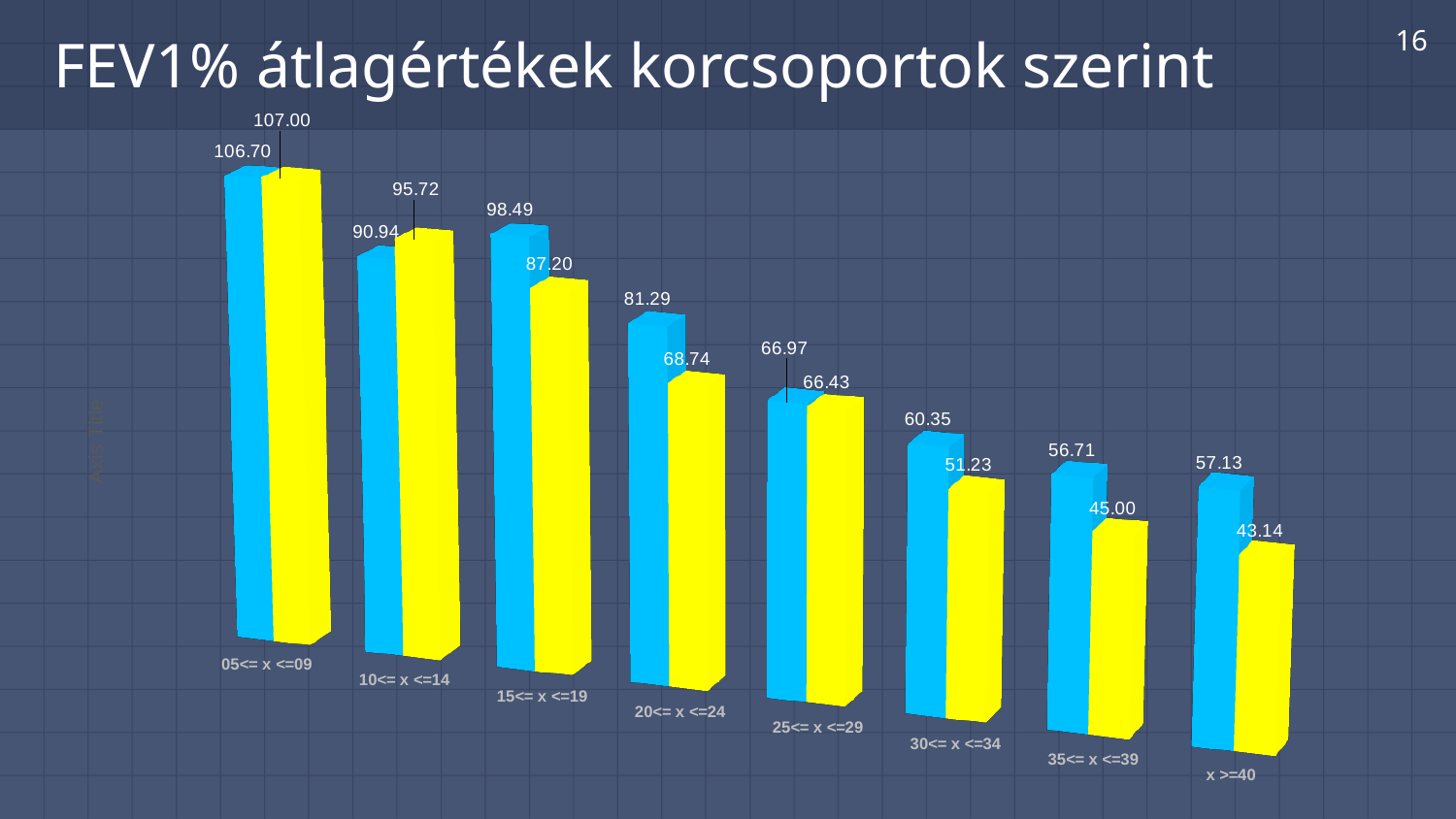
What kind of chart is shown on the slide? bar chart What is the value of the blue bar for the 05<= x <=09 age group? 106.70 What is the value of the blue bar for the 20<= x <=24 age group? 81.29 What is the difference between the blue and yellow bars for the 15<= x <=19 age group? 11.29 For the 10<= x <=14 age group, which is larger, the blue bar or the yellow bar? the yellow bar How many data series are plotted in the chart? 2 Do the yellow bar values generally rise or fall from the youngest to the oldest age group? fall Which age group has the highest blue bar? 05<= x <=09 What is the value of the yellow bar for the 05<= x <=09 age group? 107.00 How many age groups are shown on the x axis? 8 Which age group has the lowest yellow bar? x >=40 What is the value of the yellow bar for the x >=40 age group? 43.14